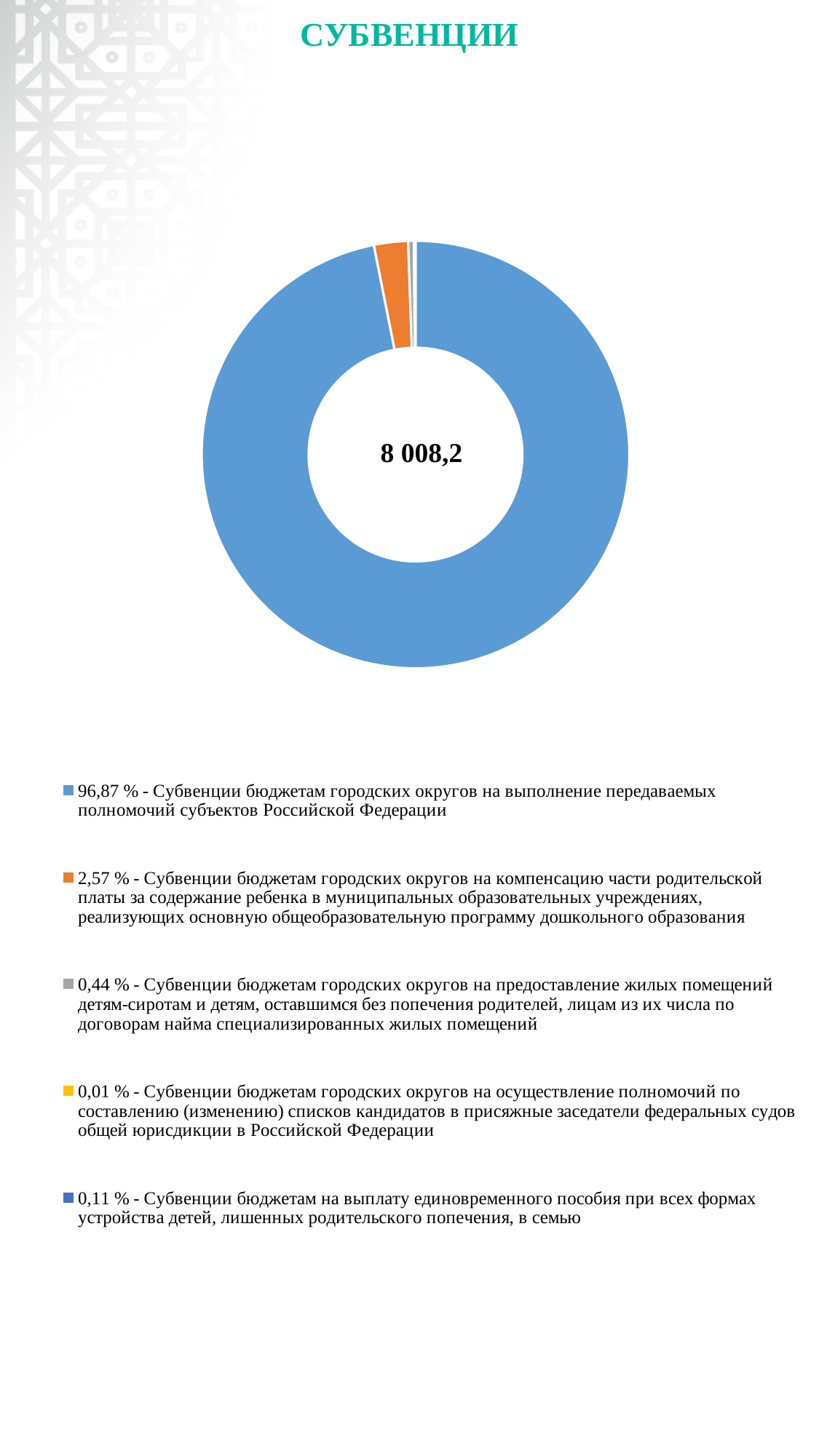
What percentage is shown for 'Субвенции бюджетам городских округов на компенсацию части родительской платы за содержание ребенка в муниципальных образовательных учреждениях'? 2,57 % What share of the chart is 'Субвенции бюджетам городских округов на выполнение передаваемых полномочий субъектов Российской Федерации'? 96,87 % What value is printed in the centre of the doughnut chart? 8 008,2 What percentage is shown for 'Субвенции бюджетам на выплату единовременного пособия при всех формах устройства детей, лишенных родительского попечения, в семью'? 0,11 % What percentage is shown for 'Субвенции бюджетам городских округов на предоставление жилых помещений детям-сиротам и детям, оставшимся без попечения родителей'? 0,44 % What is the difference in percentage points between the share for 'выполнение передаваемых полномочий субъектов Российской Федерации' (96,87 %) and the share for 'компенсацию части родительской платы' (2,57 %)? 94,30 % Which share is larger: 'предоставление жилых помещений детям-сиротам' or 'выплату единовременного пособия при всех формах устройства детей'? Предоставление жилых помещений детям-сиротам (0,44 %) What percentage is shown for 'Субвенции бюджетам городских округов на осуществление полномочий по составлению (изменению) списков кандидатов в присяжные заседатели'? 0,01 % Which category has the largest share of the chart? Субвенции бюджетам городских округов на выполнение передаваемых полномочий субъектов Российской Федерации Which category has the smallest share of the chart? Субвенции бюджетам городских округов на осуществление полномочий по составлению (изменению) списков кандидатов в присяжные заседатели федеральных судов общей юрисдикции в Российской Федерации How many categories does the legend of the chart list? 5 What kind of chart is shown on the slide? Doughnut chart